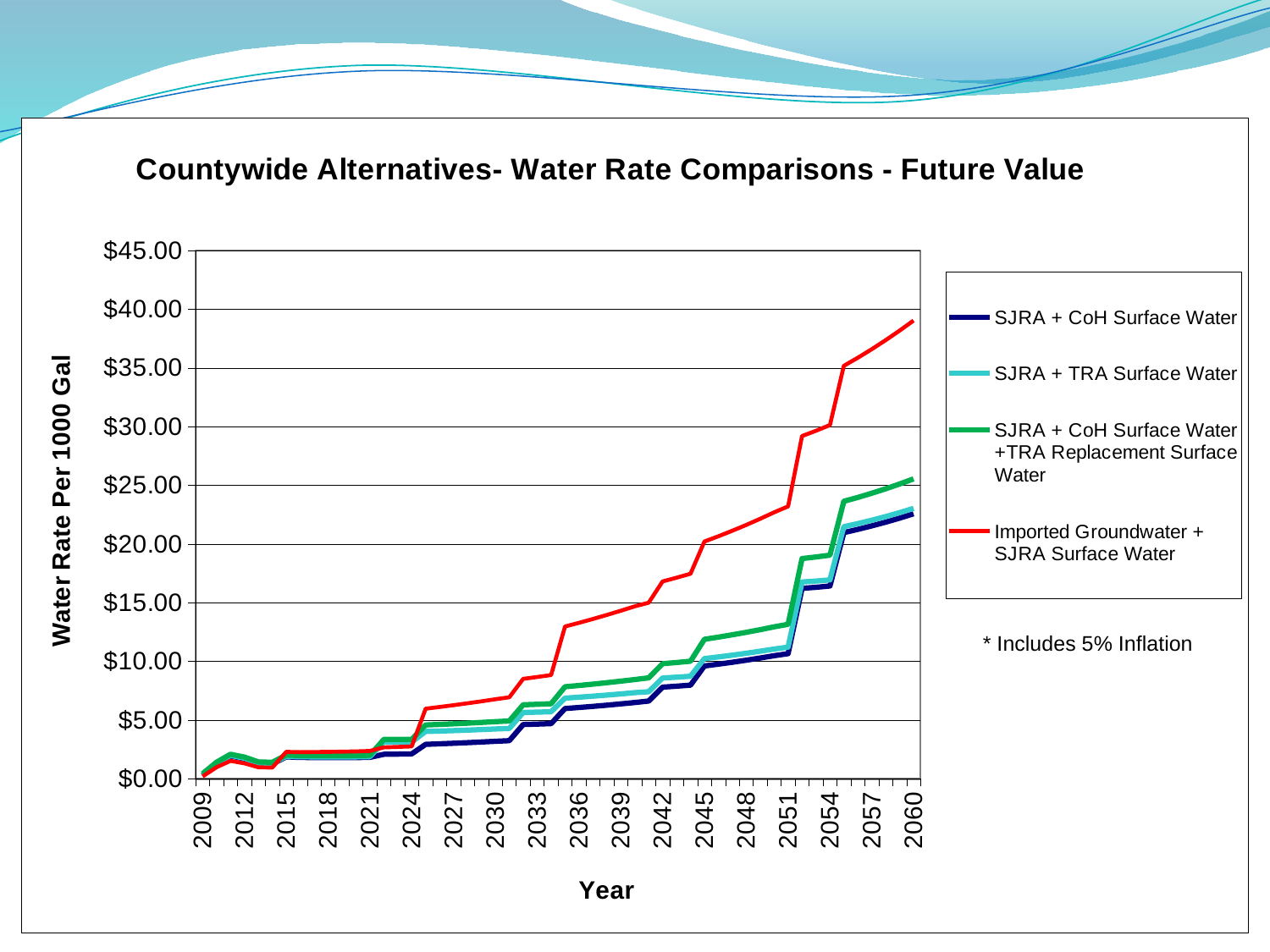
What kind of chart is shown on the slide? Line chart Is the value for SJRA + TRA Surface Water in 2045 greater or less than $15.00? less Do the water rates rise or fall from 2009 to 2060? Rise Is the value for SJRA + CoH Surface Water in 2060 greater or less than $25.00? less How many series does the legend list? 4 In 2060, which is larger: Imported Groundwater + SJRA Surface Water or SJRA + CoH Surface Water +TRA Replacement Surface Water? Imported Groundwater + SJRA Surface Water Is the value for Imported Groundwater + SJRA Surface Water in 2051 greater or less than $25.00? less Which series has the highest value in 2060? Imported Groundwater + SJRA Surface Water What is the title of the chart? Countywide Alternatives- Water Rate Comparisons - Future Value What is the label on the vertical axis? Water Rate Per 1000 Gal What is the last year shown on the x axis? 2060